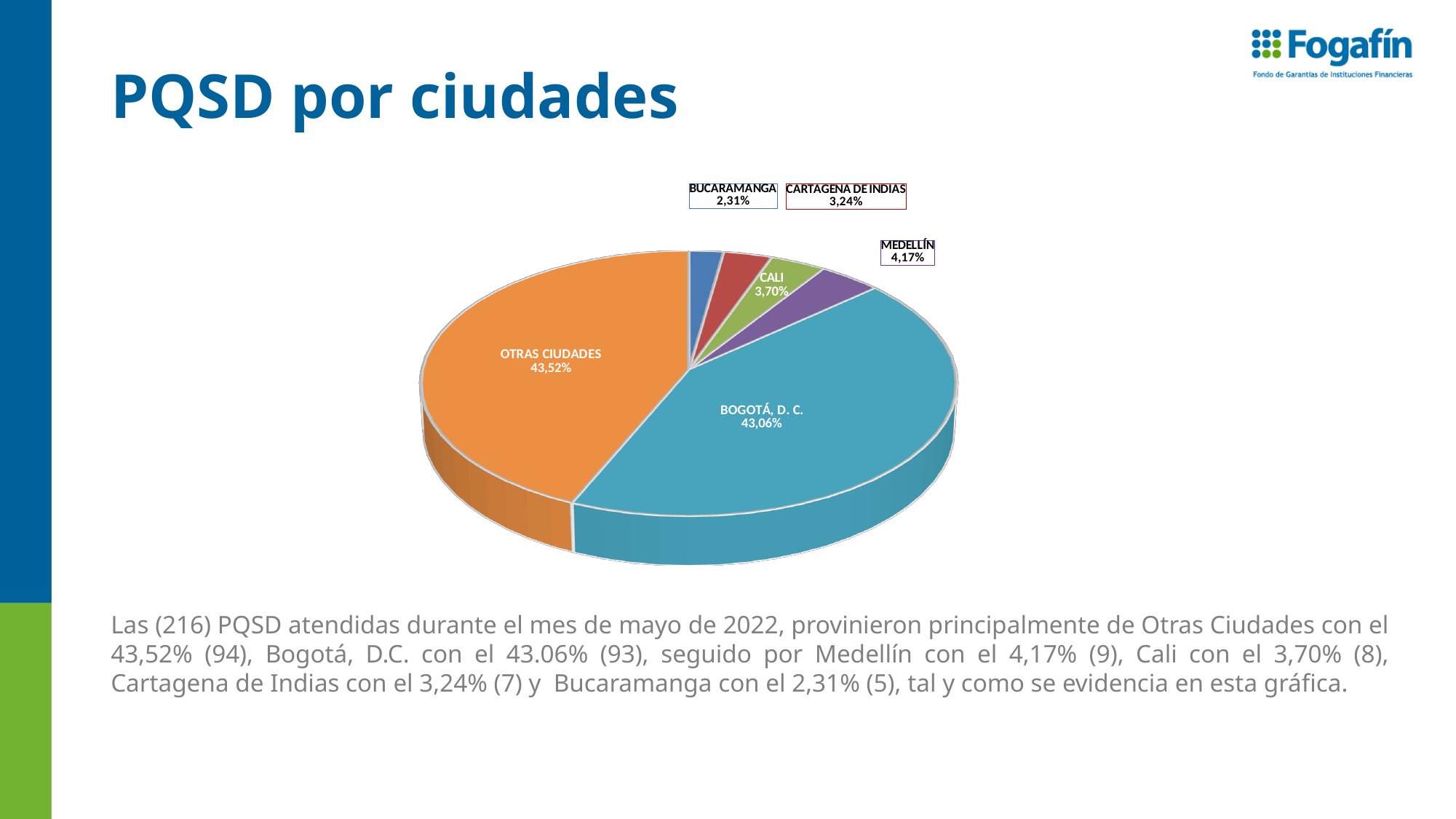
Which is larger, the value for Medellín or the value for Cali? Medellín What is the value shown for Bucaramanga? 2,31% What is the difference between the values for Otras Ciudades and Bogotá, D. C.? 0,46% How many slices does the pie chart have? 6 Which category has the largest slice of the pie? Otras Ciudades What kind of chart is shown on the slide? Pie chart What is the value shown for Cartagena de Indias? 3,24% What is the value shown for Medellín? 4,17% What is the value shown for Bogotá, D. C.? 43,06% What share of the pie does Otras Ciudades represent? 43,52% Which category has the smallest slice of the pie? Bucaramanga What is the value shown for Cali? 3,70%